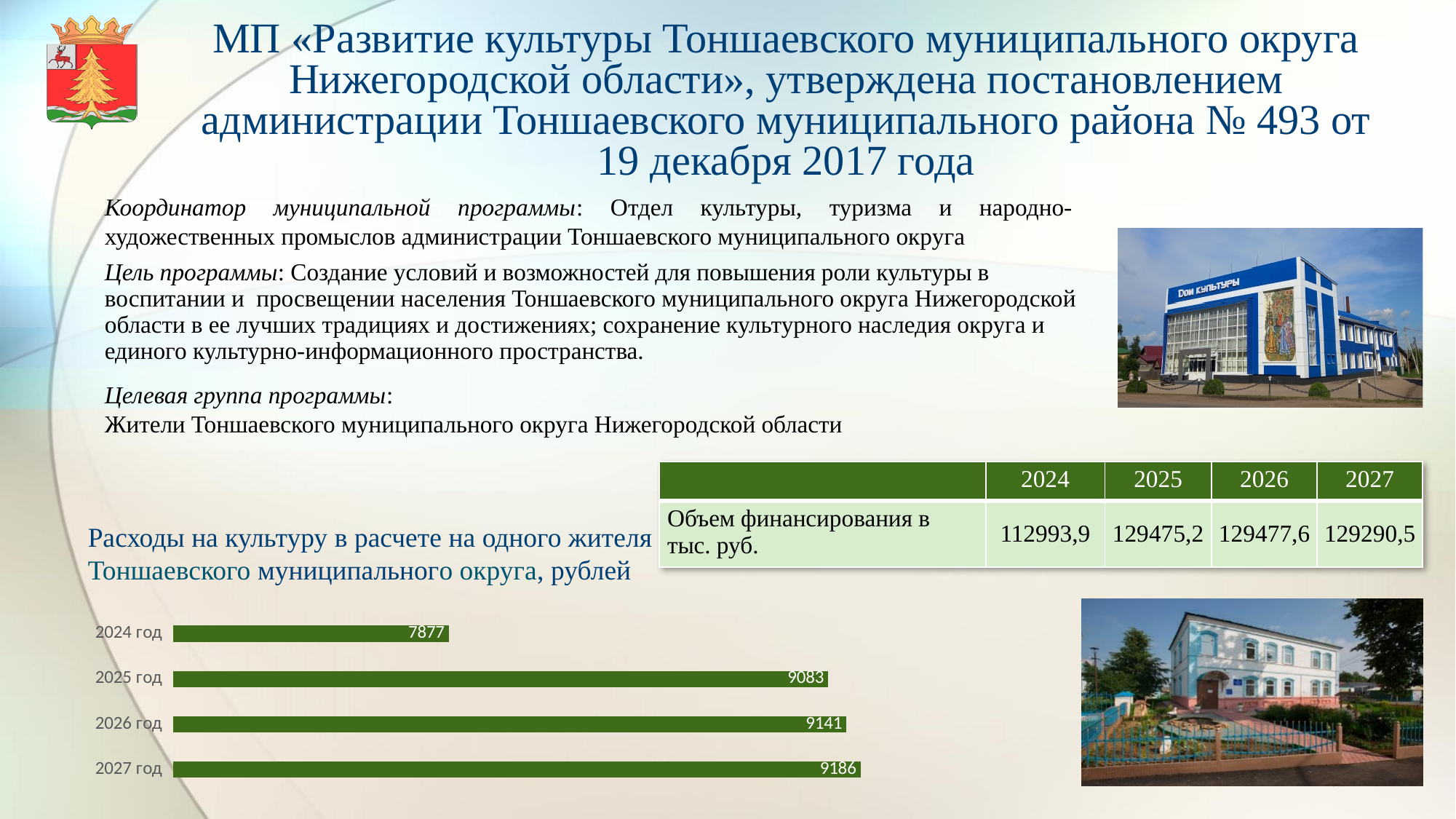
What is the value for 2024 год in the chart? 7877 What is the value for 2026 год in the chart? 9141 Which is larger, the value for 2025 год or the value for 2024 год? 2025 год What is the value for 2025 год in the chart? 9083 How many bars are shown in the chart? 4 Which year has the highest value in the chart? 2027 год What is the difference between the values for 2025 год and 2024 год? 1206 What is the value for 2027 год in the chart? 9186 What is the difference between the values for 2027 год and 2024 год? 1309 Do the values in the chart rise or fall from 2024 год to 2027 год? Rise Which year has the lowest value in the chart? 2024 год What type of chart is shown on the slide? Bar chart